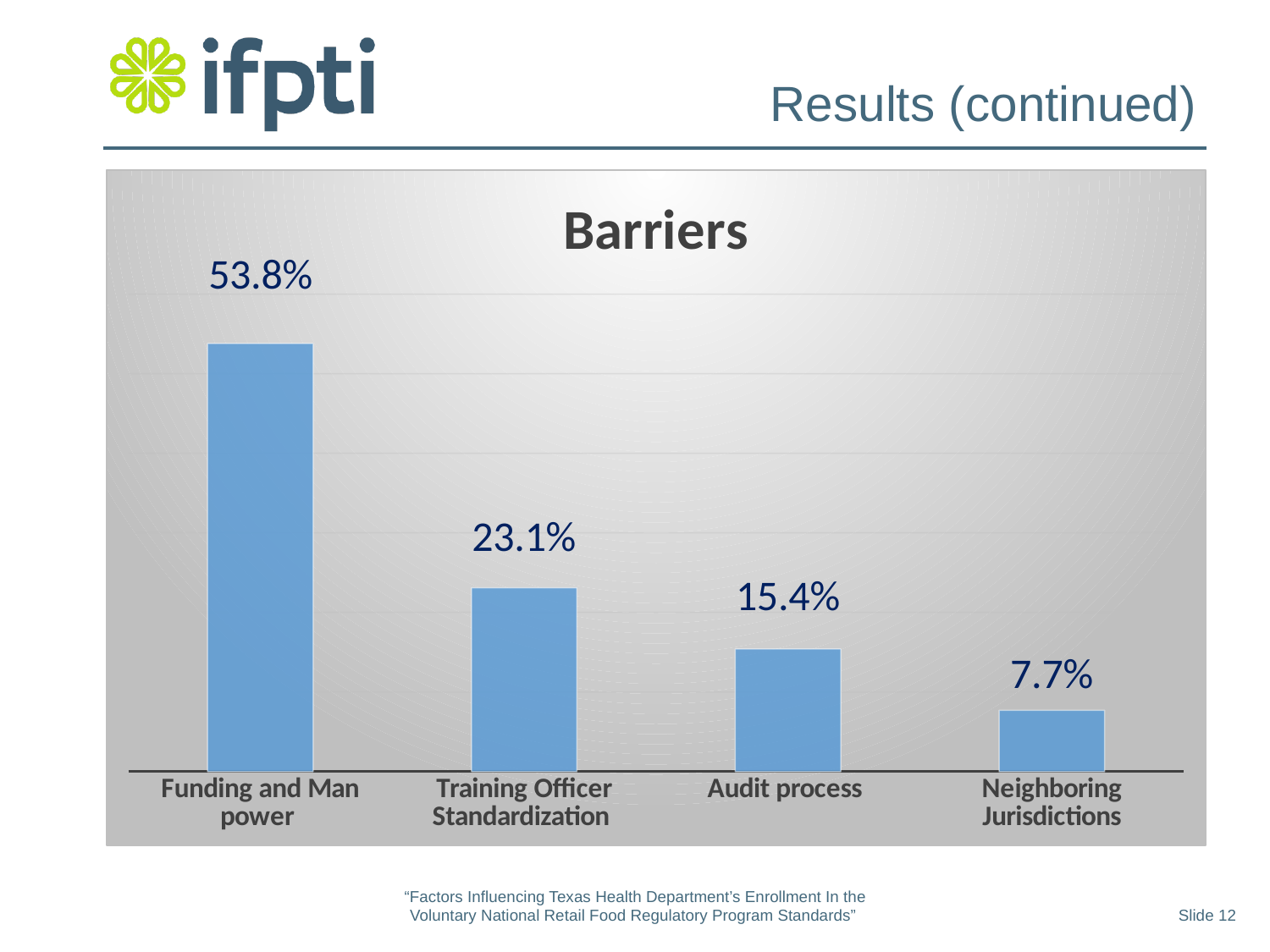
What is the difference between the values for Audit process and Neighboring Jurisdictions? 7.7% What kind of chart is shown on the slide? Bar chart How many categories are shown in the chart? 4 Which is larger, the value for Training Officer Standardization or the value for Audit process? Training Officer Standardization What is the value for Training Officer Standardization? 23.1% What is the value for Neighboring Jurisdictions? 7.7% What is the title of the chart? Barriers What is the difference between the values for Funding and Man power and Training Officer Standardization? 30.7% Which barrier has the highest value? Funding and Man power What is the value for Audit process? 15.4% What is the value for Funding and Man power? 53.8% Which barrier has the lowest value? Neighboring Jurisdictions